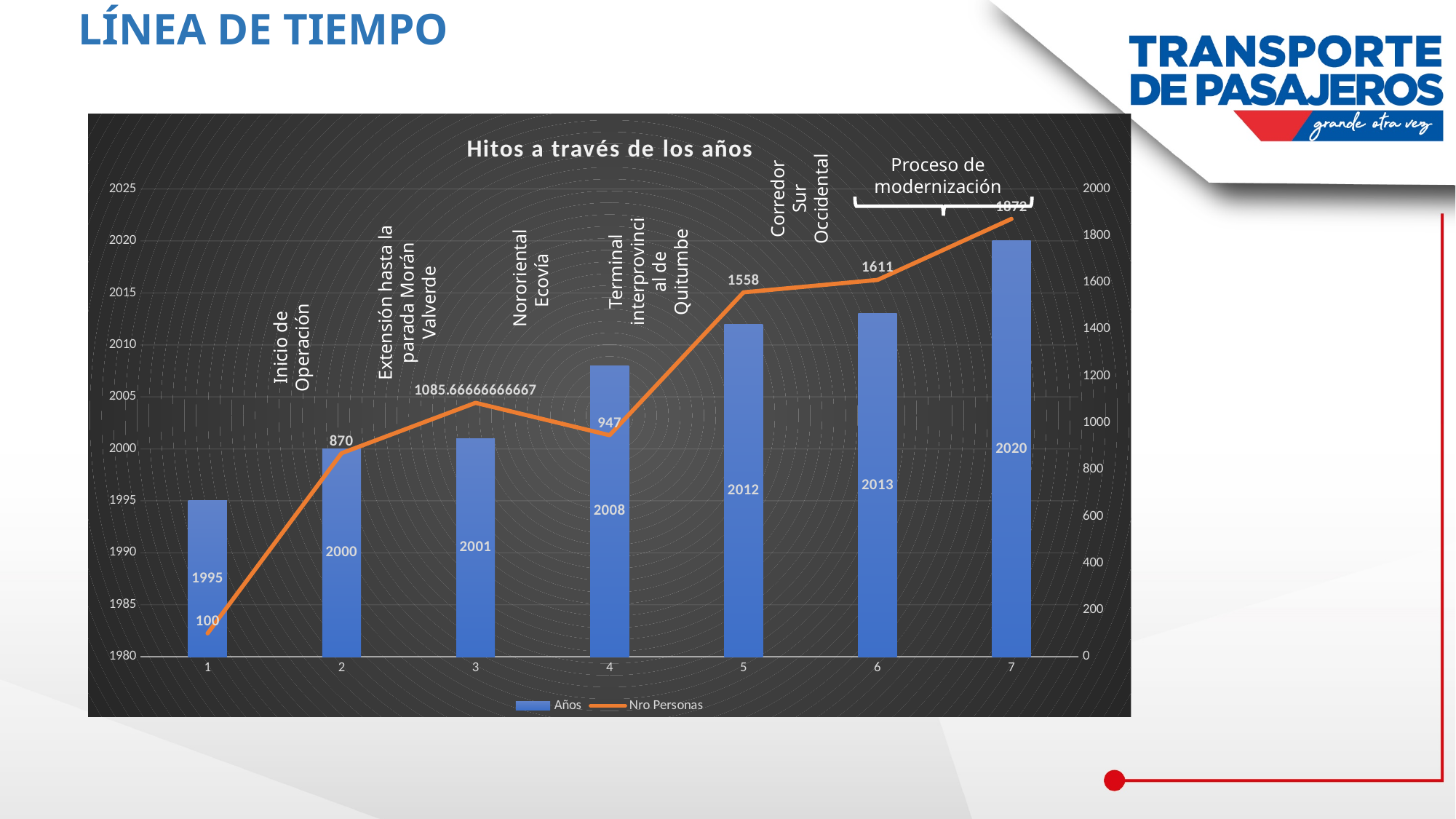
What is the Nro Personas value at category 6? 1611 Do the Años bar values rise or fall from category 1 to category 7? Rise How many series does the chart legend list? 2 What kind of chart is shown on the slide? Combined bar and line chart What is the difference between the Nro Personas values at category 6 and category 5? 53 Which has a larger Nro Personas value, category 3 or category 4? Category 3 What is the title of the chart? Hitos a través de los años What is the Nro Personas value at category 5? 1558 How many categories are shown on the x axis of the chart? 7 What is the Nro Personas value at category 2? 870 What is the Años value for the bar at category 4? 2008 Which category has the lowest Nro Personas value? 1